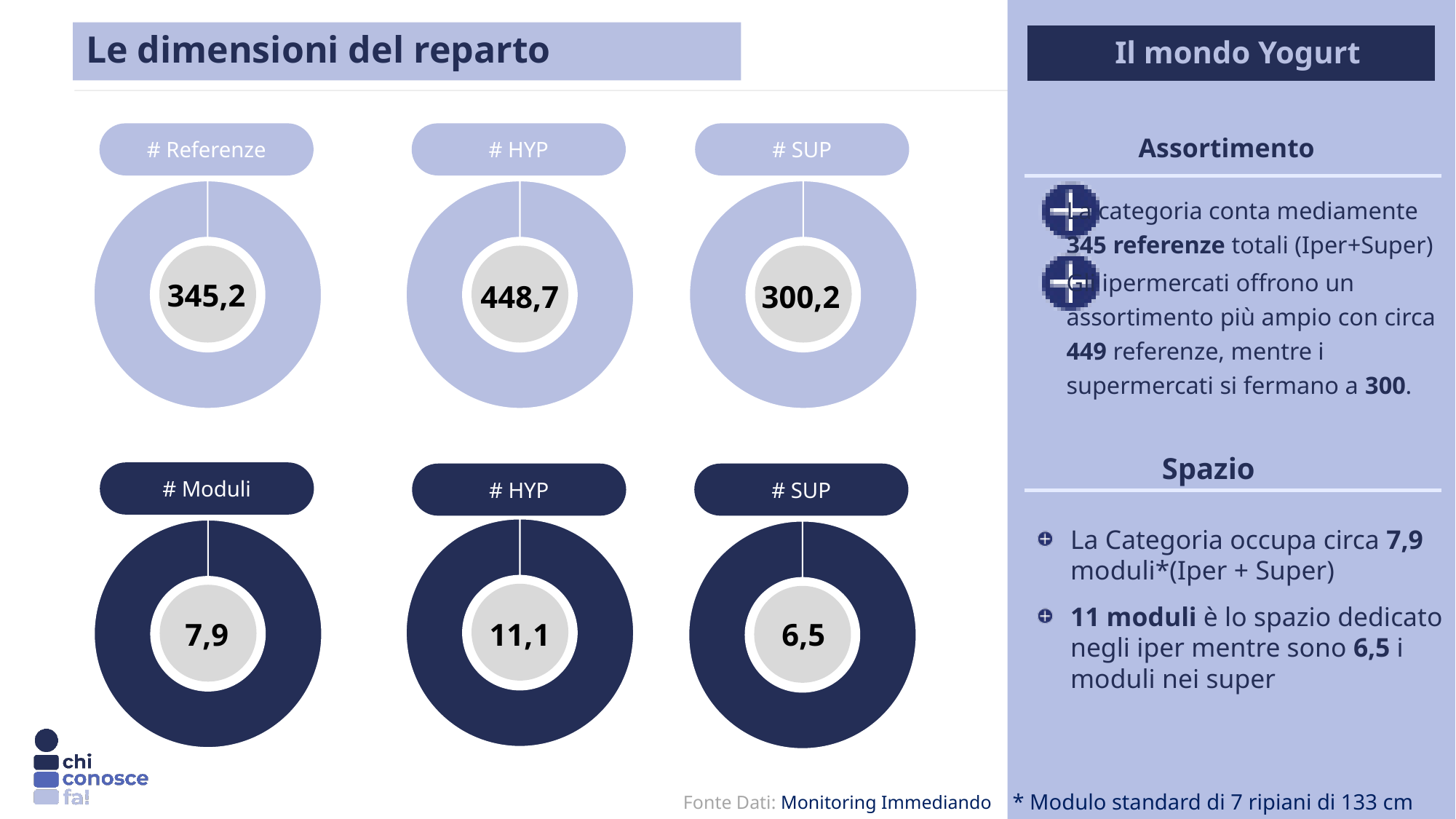
In the bottom row, what is the difference between the "# HYP" value and the "# SUP" value? 4,6 What value is shown in the "# HYP" chart in the bottom row? 11,1 In the top row, what is the difference between the "# HYP" value and the "# SUP" value? 148,5 What value is shown in the "# SUP" chart in the top row? 300,2 Among the three charts in the top row (# Referenze, # HYP, # SUP), which shows the highest value? # HYP Among the three charts in the bottom row (# Moduli, # HYP, # SUP), which shows the lowest value? # SUP How many circular (doughnut-style) charts are shown on the slide? 6 What value is shown in the "# Moduli" chart in the bottom row? 7,9 In the bottom row, is the "# HYP" value larger or smaller than the "# Moduli" value? larger What value is shown in the "# HYP" chart in the top row? 448,7 What value is shown in the "# SUP" chart in the bottom row? 6,5 What value is shown in the centre of the "# Referenze" chart in the top row? 345,2